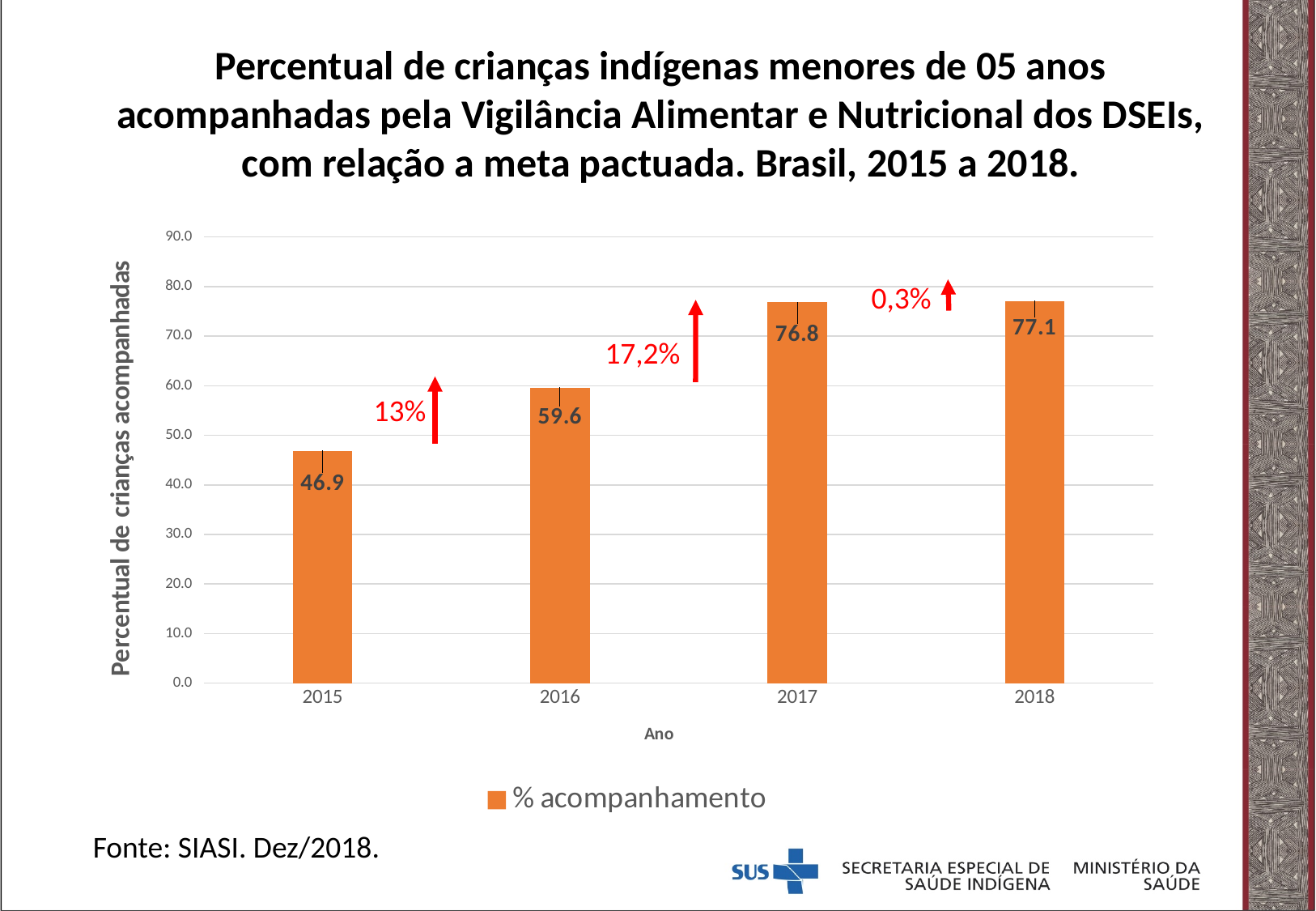
Is the value for 2016 greater or less than 50.0? greater What is the value for 2018? 77.1 Which year has the lowest value? 2015 Which is larger, the value for 2016 or the value for 2017? 2017 What is the difference between the values for 2016 and 2015? 12.7 Do the values rise or fall from 2015 to 2018? rise What kind of chart is shown? bar chart Which year has the highest value? 2018 How many years are shown on the x axis? 4 How many series does the legend list? 1 What is the value for 2017? 76.8 What is the value for 2015? 46.9